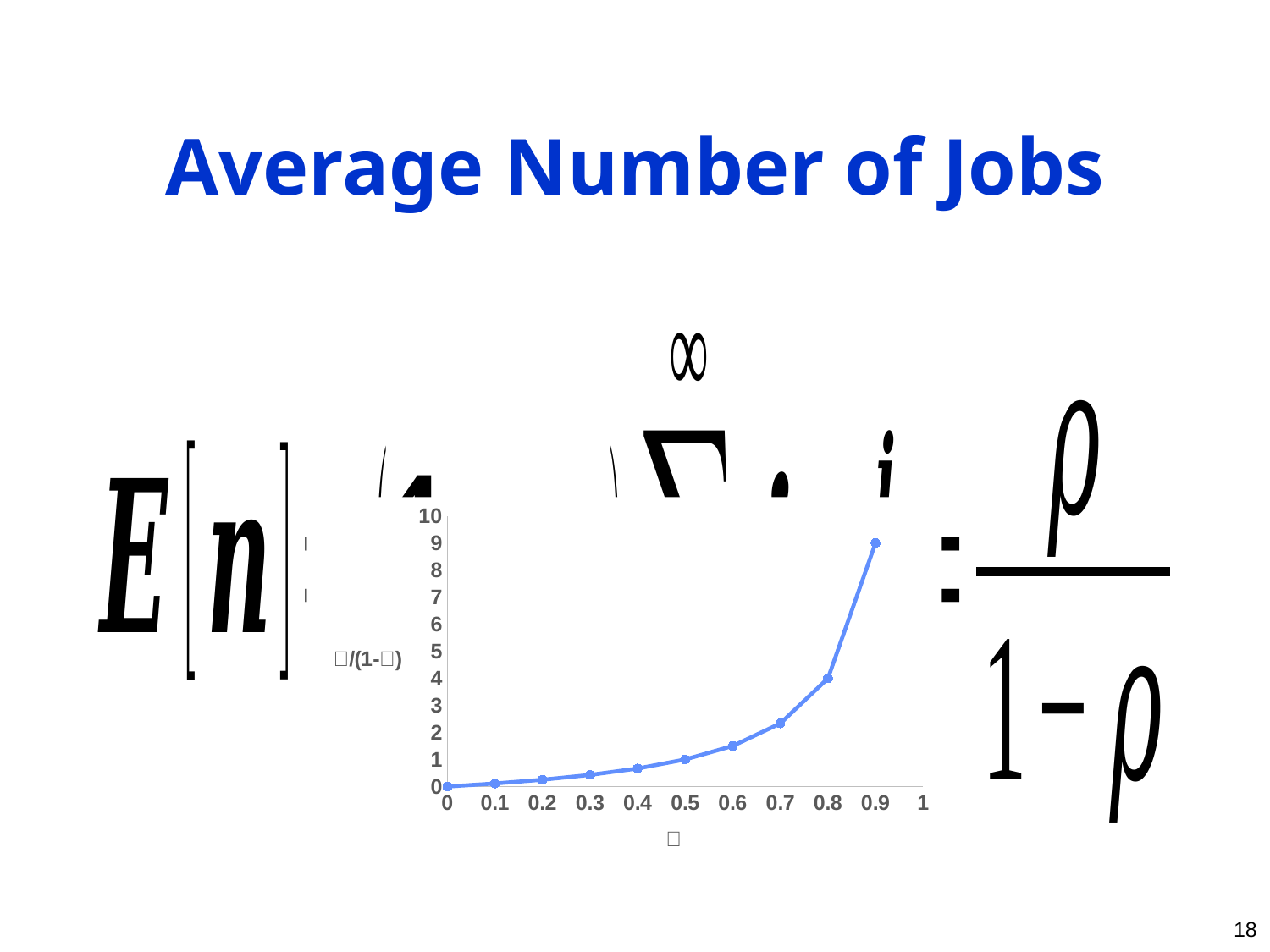
What kind of chart is shown on the slide? line chart At which x-axis value is the plotted value highest? 0.9 Is the plotted value at x = 0.3 greater or less than 1? less Do the plotted values rise or fall as the x-axis value increases from 0 to 0.9? rise What is the plotted value at x = 0.9? 9 Which has the larger plotted value, x = 0.6 or x = 0.8? 0.8 What is the plotted value at x = 0.5? 1 At which x-axis value is the plotted value lowest? 0 How many data points are plotted on the line? 10 Is the plotted value at x = 0.7 greater or less than 2? greater What is the plotted value at x = 0.8? 4 What is the difference between the plotted values at x = 0.9 and x = 0.8? 5